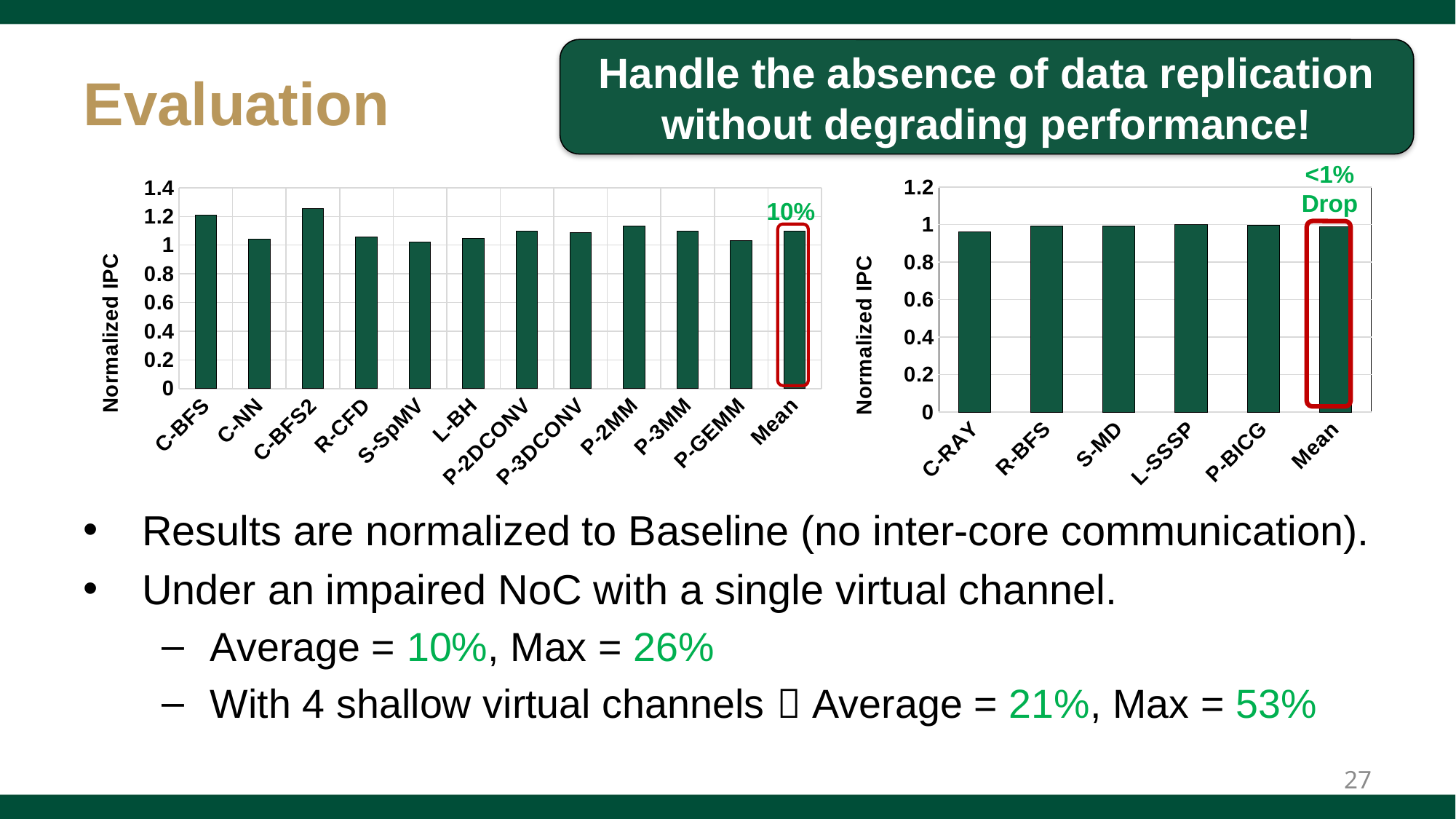
What annotation is written above the highlighted Mean bar in the left chart? 10% In the left chart, which is larger, the value for C-BFS or the value for C-NN? C-BFS In the right chart, is the value for C-RAY greater or less than 0.8? greater What is the y-axis label of the left chart? Normalized IPC In the left chart, is the value for C-BFS2 greater or less than 1.2? greater In the left chart, how many categories are shown on the x axis? 12 In the left chart, which category has the highest normalized IPC? C-BFS2 In the left chart, is the value for C-NN greater or less than 1.2? less In the right chart, which category has the lowest normalized IPC? C-RAY In the right chart, how many categories are shown on the x axis? 6 What kind of chart is the left chart on the slide? bar chart